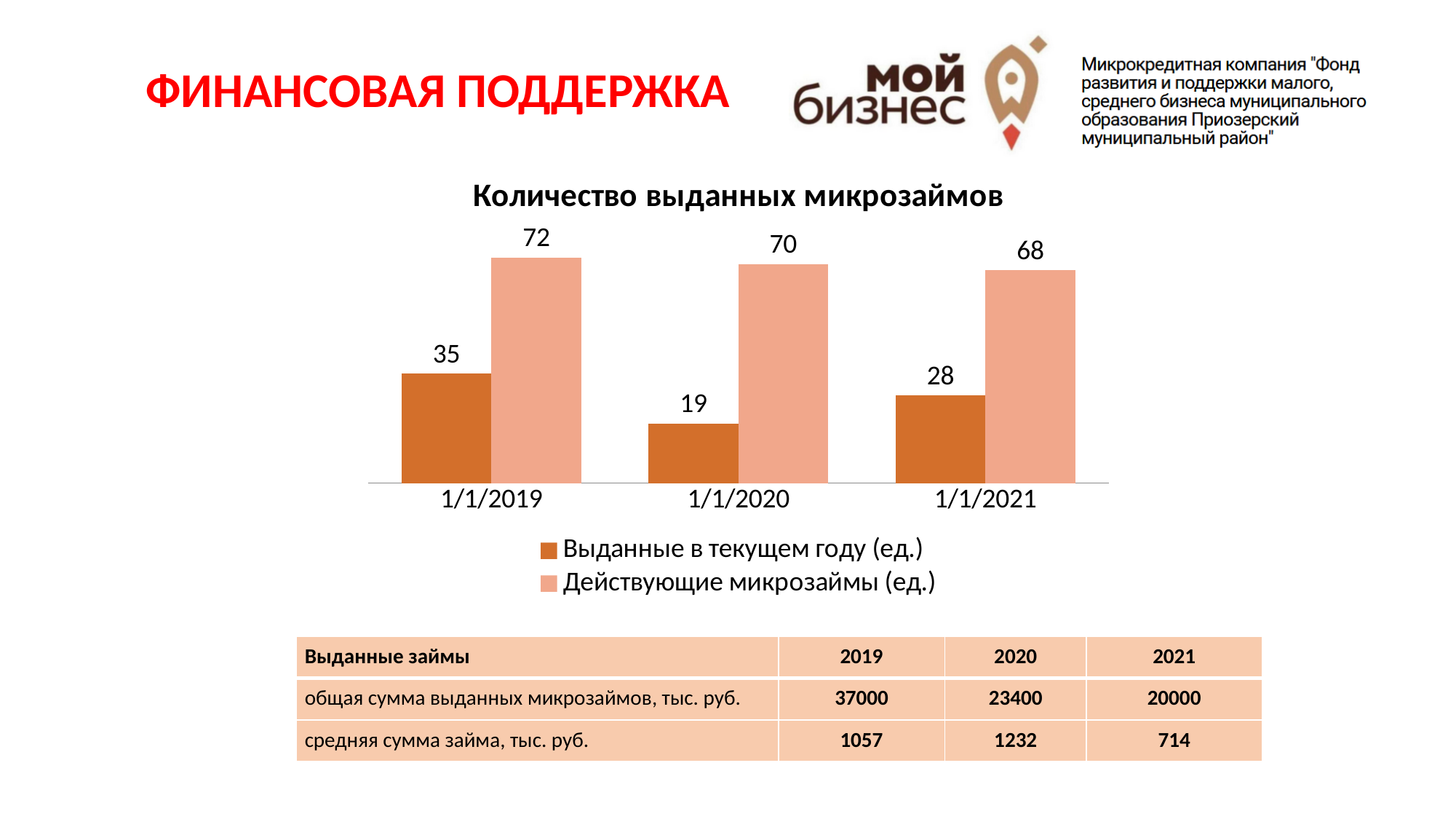
What is the value of 'Выданные в текущем году (ед.)' for 1/1/2021? 28 Which is larger: 'Выданные в текущем году (ед.)' for 1/1/2019 or for 1/1/2021? 1/1/2019 How many series does the chart legend list? 2 What is the value of 'Действующие микрозаймы (ед.)' for 1/1/2020? 70 Which date has the lowest value for 'Выданные в текущем году (ед.)'? 1/1/2020 What is the title of the chart? Количество выданных микрозаймов How many dates are shown on the x axis of the chart? 3 What kind of chart is shown on the slide? Bar chart What is the value of 'Выданные в текущем году (ед.)' for 1/1/2019? 35 What is the difference between 'Действующие микрозаймы (ед.)' and 'Выданные в текущем году (ед.)' for 1/1/2021? 40 Which date has the highest value for 'Действующие микрозаймы (ед.)'? 1/1/2019 Does the value of 'Действующие микрозаймы (ед.)' rise or fall from 1/1/2019 to 1/1/2021? Fall